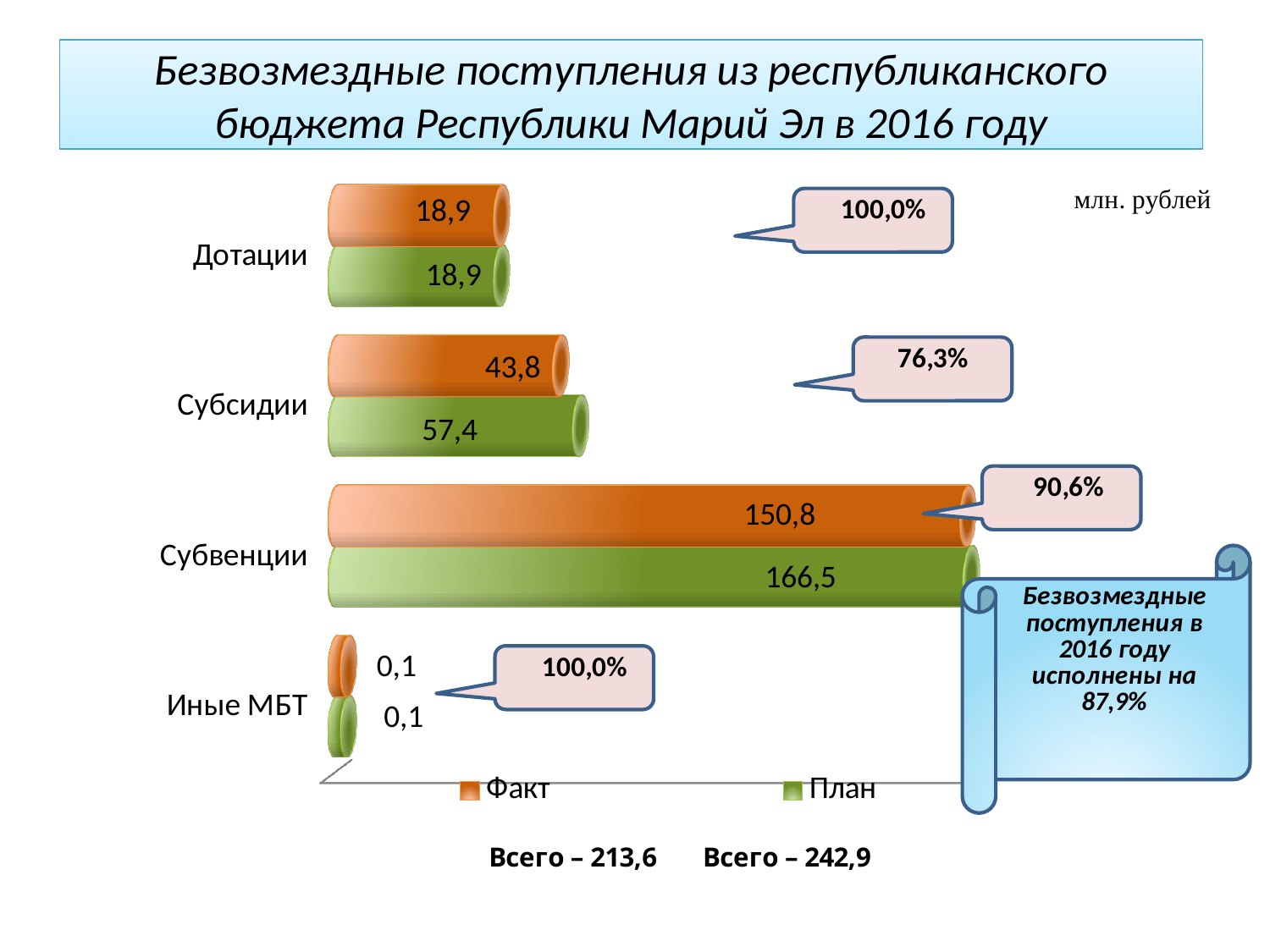
What is the Факт value for Субвенции? 150,8 What is the План value for Субсидии? 57,4 Which category has the highest План value? Субвенции Which series is shown in orange according to the legend? Факт What kind of chart is shown on the slide? bar chart How many categories are shown on the chart? 4 What is the difference between the План and Факт values for Субсидии? 13,6 How many series does the legend list? 2 What is the difference between the План and Факт values for Субвенции? 15,7 Which category has the lowest Факт value? Иные МБТ Which is larger for Субсидии, the Факт value or the План value? План What is the План value for Дотации? 18,9